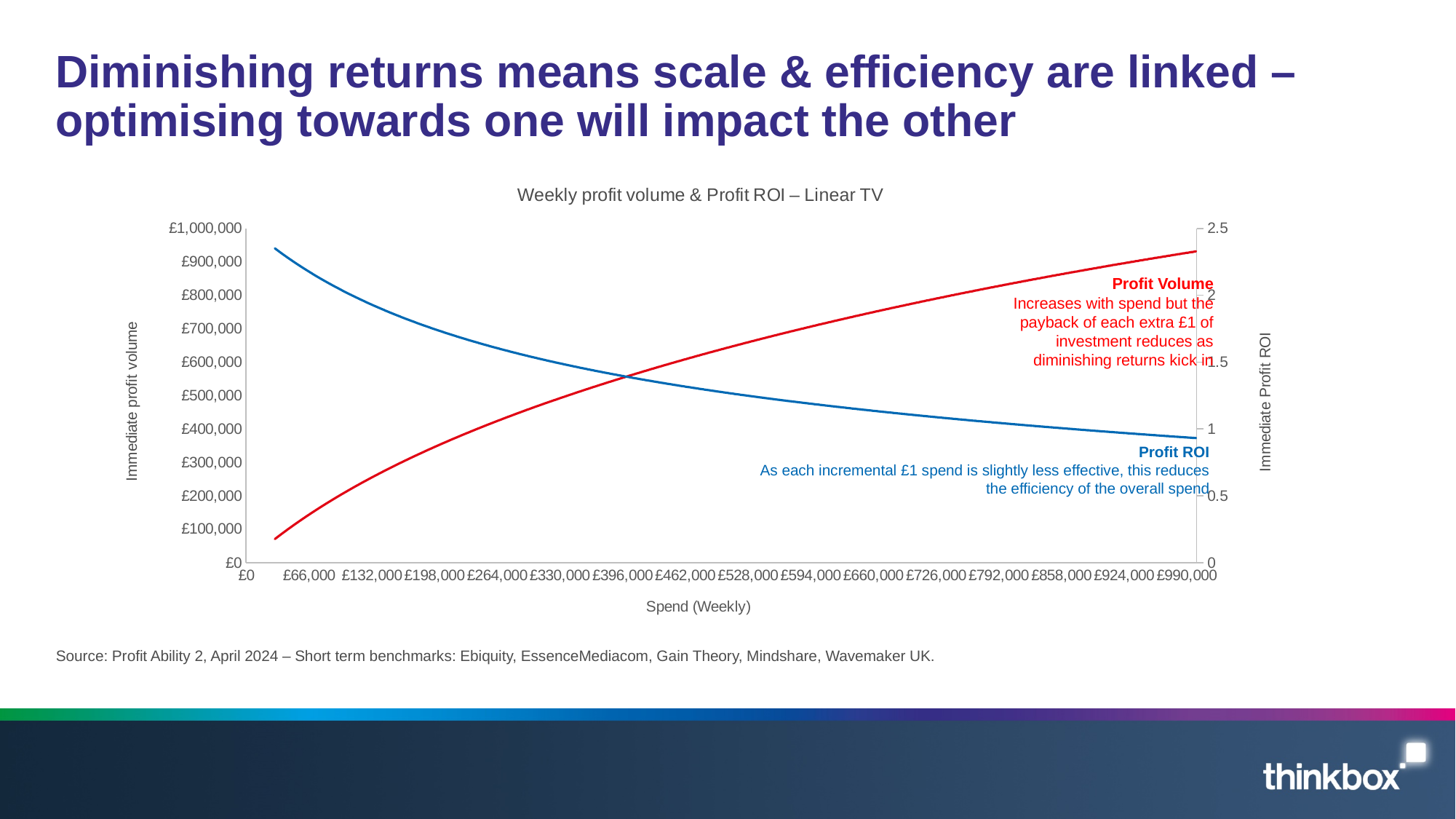
Is the Profit Volume value at the highest spend shown greater or less than £800,000? greater Is the Profit ROI value at the lowest spend shown greater or less than 2? greater Does the Profit Volume line rise or fall as weekly spend increases? rises How many series are plotted on the chart? 2 Is the Profit ROI value at the highest spend shown greater or less than 1.5? less What is the label of the x axis? Spend (Weekly) What is the title of the chart? Weekly profit volume & Profit ROI – Linear TV What kind of chart is shown on the slide? line chart Does the Profit ROI line rise or fall as weekly spend increases? falls Which series is plotted against the right-hand axis labelled Immediate Profit ROI? Profit ROI